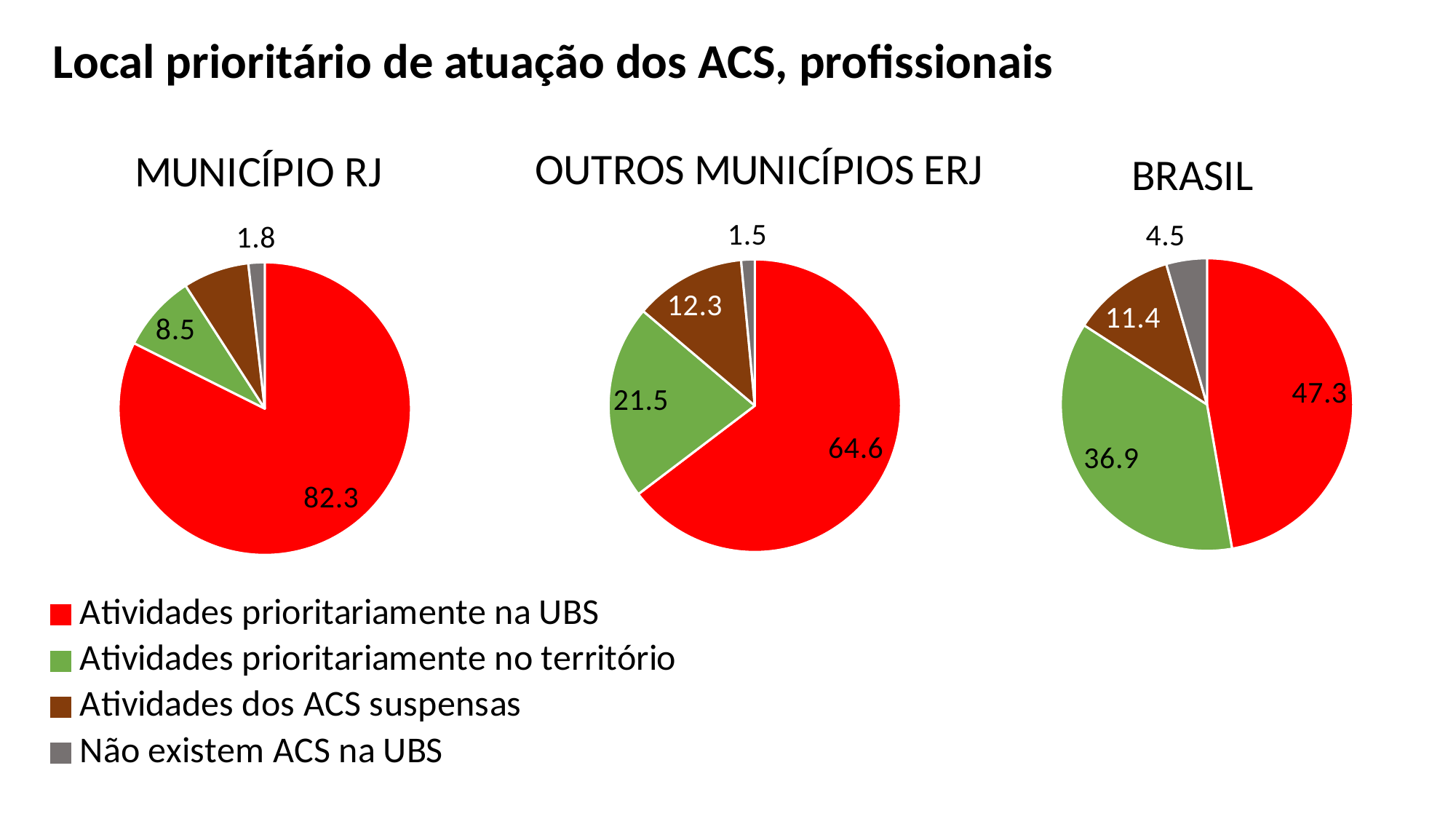
In the BRASIL chart, what is the value for Atividades prioritariamente no território? 36.9 What type of chart is used on this slide? Pie chart In the OUTROS MUNICÍPIOS ERJ chart, what is the value for Atividades dos ACS suspensas? 12.3 In the MUNICÍPIO RJ chart, what is the value for Atividades prioritariamente na UBS? 82.3 In the OUTROS MUNICÍPIOS ERJ chart, what is the difference between Atividades prioritariamente no território and Atividades dos ACS suspensas? 9.2 How many categories does the legend list? 4 In the OUTROS MUNICÍPIOS ERJ chart, which category has the largest slice? Atividades prioritariamente na UBS In the MUNICÍPIO RJ chart, what is the value for Atividades prioritariamente no território? 8.5 In the BRASIL chart, what is the difference between Atividades prioritariamente na UBS and Atividades prioritariamente no território? 10.4 In the BRASIL chart, which category has the smallest slice? Não existem ACS na UBS Which is larger: Atividades prioritariamente na UBS in the MUNICÍPIO RJ chart or in the BRASIL chart? MUNICÍPIO RJ In the BRASIL chart, what is the value for Não existem ACS na UBS? 4.5